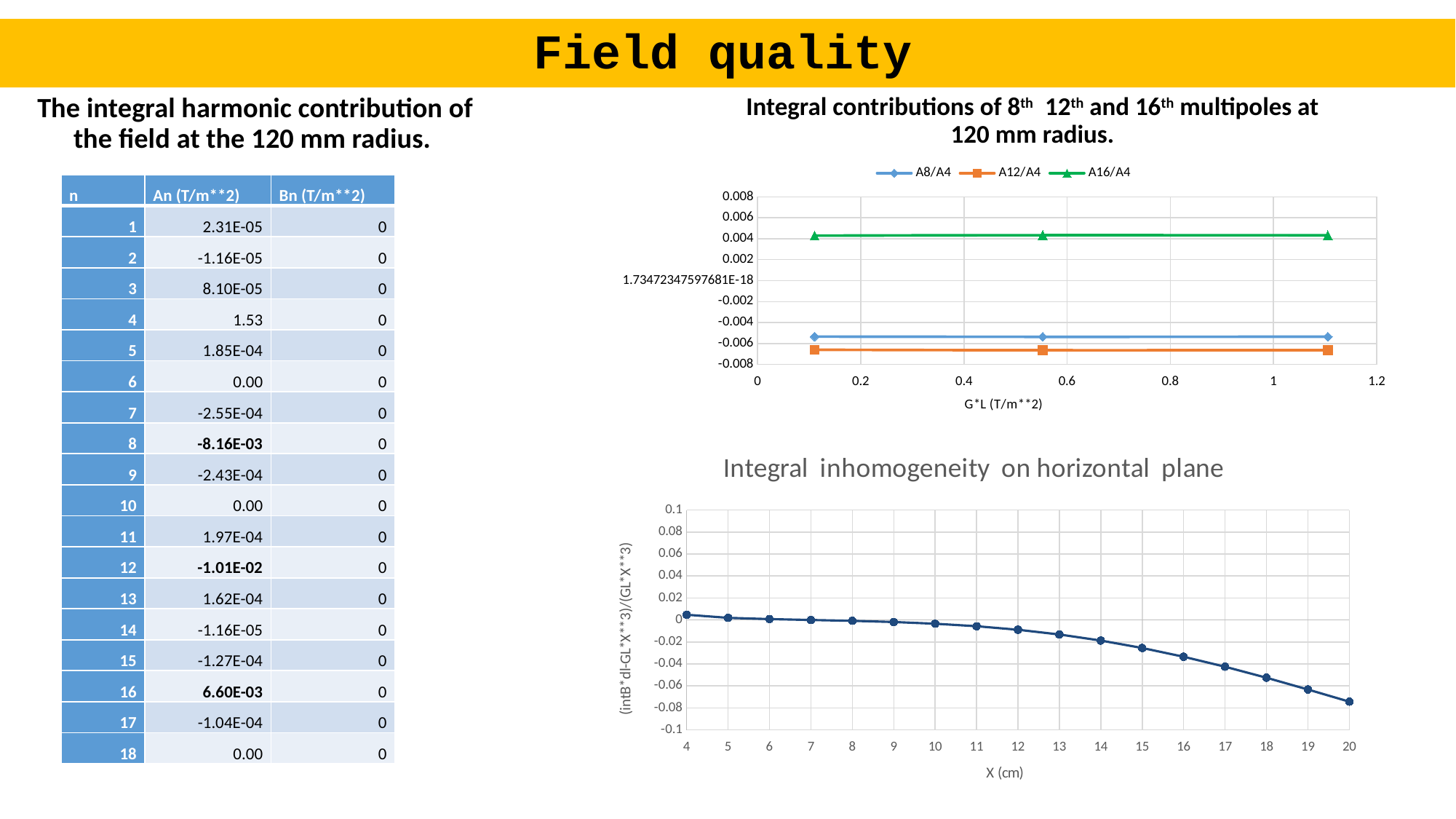
What kind of chart is the 'Integral contributions of 8th 12th and 16th multipoles at 120 mm radius' chart? line chart What is the x-axis label of the 'Integral contributions of 8th 12th and 16th multipoles' chart? G*L (T/m**2) In the 'Integral contributions of 8th 12th and 16th multipoles' chart, is the value of A12/A4 greater or less than -0.006? less In the 'Integral inhomogeneity on horizontal plane' chart, is the value at X = 20 cm greater or less than -0.06? less In the 'Integral contributions of 8th 12th and 16th multipoles' chart, is the value of A16/A4 greater or less than 0.002? greater What kind of chart is the 'Integral inhomogeneity on horizontal plane' chart? line chart In the 'Integral inhomogeneity on horizontal plane' chart, do the values rise or fall as X increases? fall In the 'Integral contributions of 8th 12th and 16th multipoles' chart, which series has the highest values? A16/A4 How many data points are plotted in the 'Integral inhomogeneity on horizontal plane' chart? 17 In the 'Integral contributions of 8th 12th and 16th multipoles' chart, which series is larger, A8/A4 or A12/A4? A8/A4 How many series does the legend of the 'Integral contributions of 8th 12th and 16th multipoles' chart list? 3 In the 'Integral contributions of 8th 12th and 16th multipoles' chart, which series has the lowest values? A12/A4